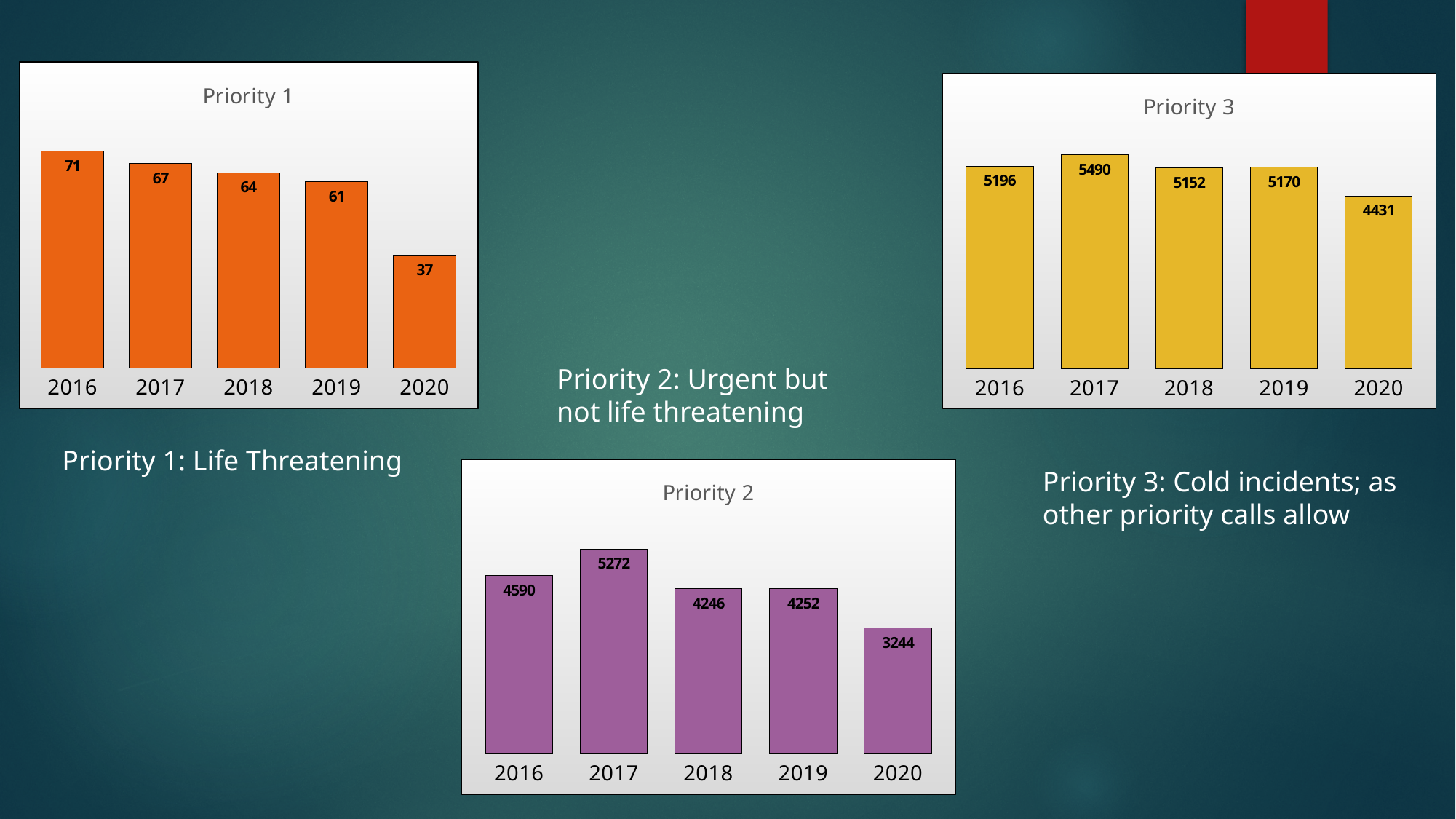
In the Priority 1 chart, do the values rise or fall from 2016 to 2020? Fall In the Priority 1 chart, what is the value for 2020? 37 What type of chart is the Priority 3 chart? Bar chart In the Priority 3 chart, what is the value for 2019? 5170 In the Priority 2 chart, which is larger, the value for 2016 or the value for 2018? 2016 How many years are shown in the Priority 2 chart? 5 In the Priority 3 chart, which year has the highest value? 2017 In the Priority 2 chart, what is the value for 2017? 5272 In the Priority 1 chart, which year has the highest value? 2016 In the Priority 2 chart, which year has the lowest value? 2020 In the Priority 1 chart, what is the difference between the 2016 and 2020 values? 34 In the Priority 3 chart, what is the difference between the 2017 and 2020 values? 1059